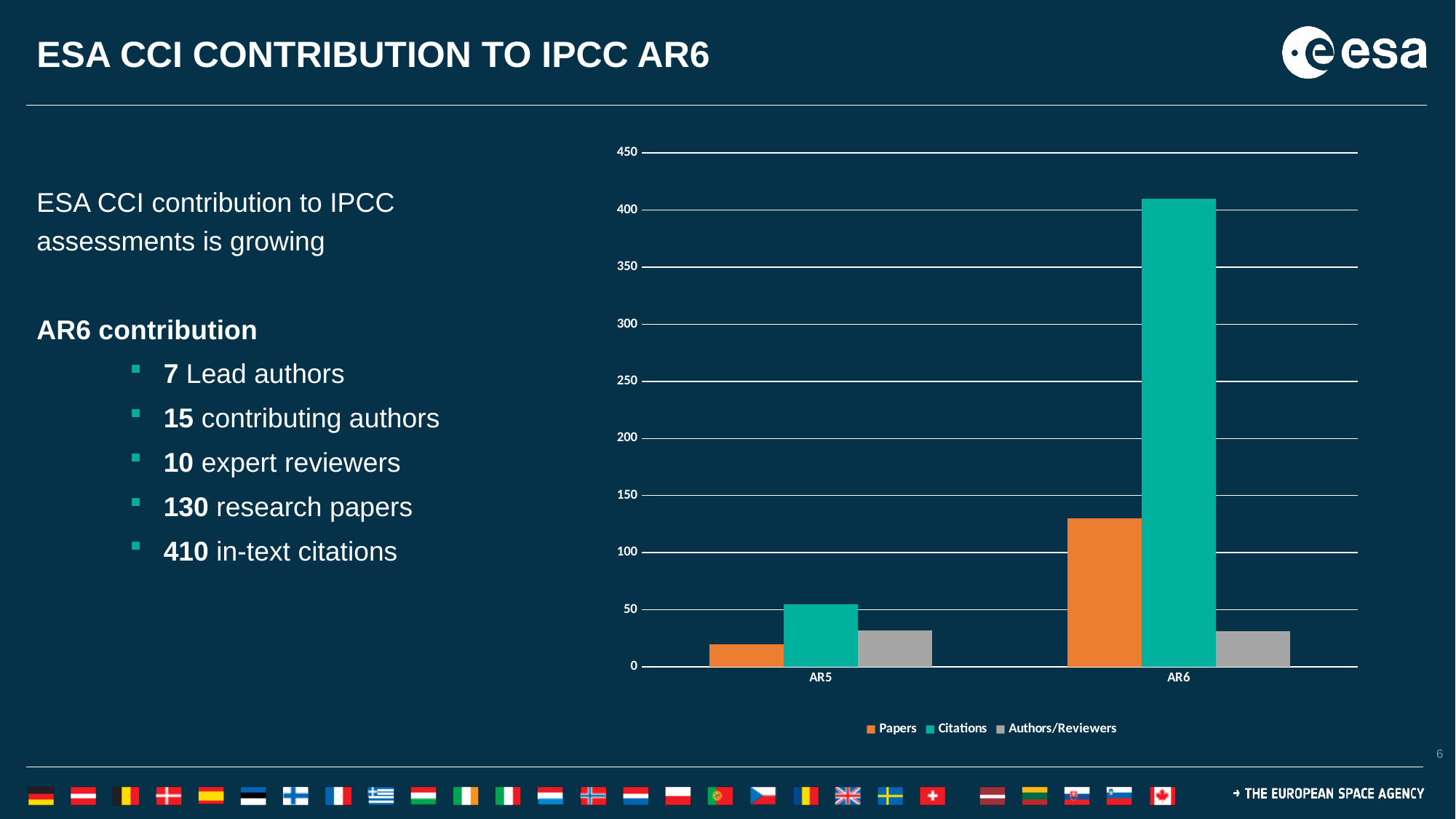
Do the values for Papers rise or fall from AR5 to AR6? rise How many series does the chart legend list? 3 What kind of chart is shown on the slide? bar chart Which series has the shortest bar in the AR5 category? Papers Is the value for Authors/Reviewers in AR6 greater or less than 50? less How many categories are shown on the x axis of the chart? 2 Which is larger, Citations for AR5 or Citations for AR6? Citations for AR6 What colour represents the Citations series in the chart? teal Is the value for Papers in AR6 greater or less than 100? greater Is the value for Citations in AR6 greater or less than 350? greater Which series and category has the tallest bar in the chart? Citations for AR6